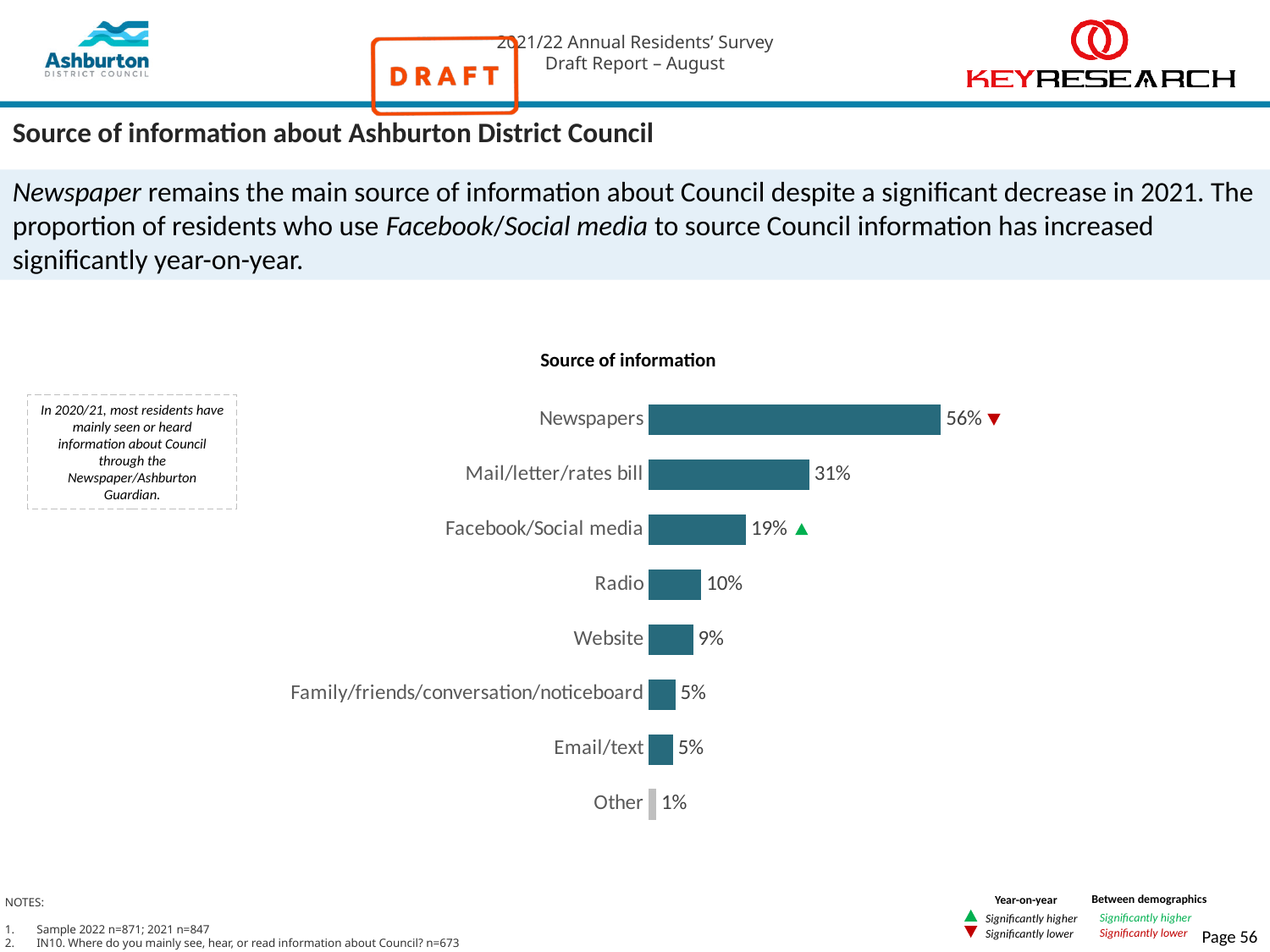
Which source of information has the lowest percentage? Other What is the title of the chart? Source of information How many sources of information are listed in the chart? 8 Which category is marked with a green upward triangle indicating a significantly higher year-on-year result? Facebook/Social media What type of chart is used to show the source of information? Bar chart What is the value for Radio? 10% Which is larger, the value for Radio or the value for Website? Radio What percentage of residents use Newspapers as a source of information about Council? 56% What percentage is shown for Facebook/Social media? 19% What is the difference in percentage points between Newspapers and Mail/letter/rates bill? 25 What is the value shown for Mail/letter/rates bill? 31% Which source of information has the highest percentage? Newspapers